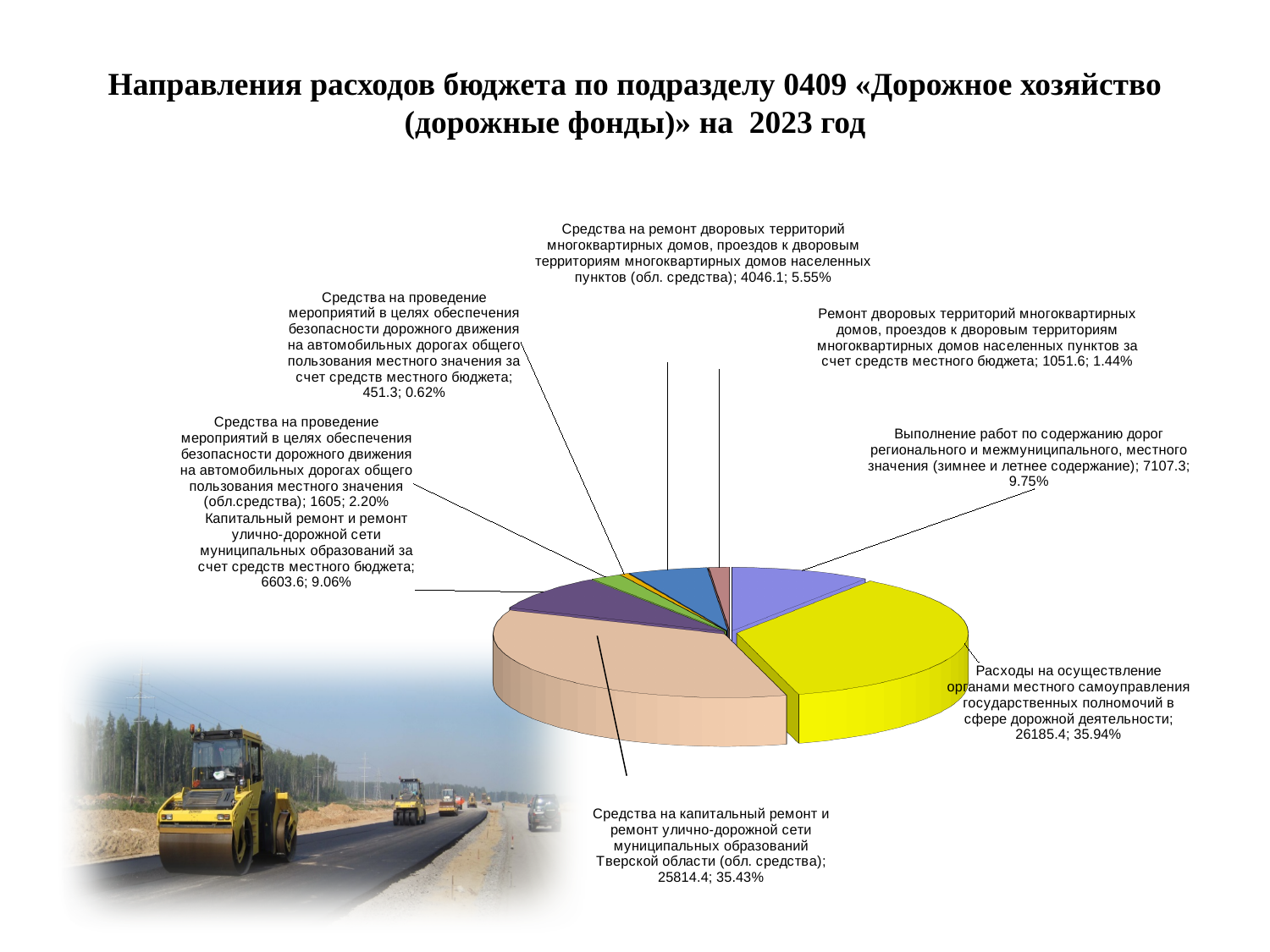
What is the difference between the values for «Средства на ремонт дворовых территорий ... (обл. средства)» (4046.1) and «Ремонт дворовых территорий ... за счет средств местного бюджета» (1051.6)? 2994.5 What kind of chart is shown on the slide? pie chart What is the difference between the values for «Расходы на осуществление органами местного самоуправления государственных полномочий в сфере дорожной деятельности» (26185.4) and «Средства на капитальный ремонт и ремонт улично-дорожной сети муниципальных образований Тверской области (обл. средства)» (25814.4)? 371 What is the value for «Выполнение работ по содержанию дорог регионального и межмуниципального, местного значения (зимнее и летнее содержание)»? 7107.3 What is the value for «Расходы на осуществление органами местного самоуправления государственных полномочий в сфере дорожной деятельности»? 26185.4 What is the value for «Средства на ремонт дворовых территорий многоквартирных домов, проездов к дворовым территориям многоквартирных домов населенных пунктов (обл. средства)»? 4046.1 How many slices does the pie chart have? 8 What share of the pie does «Капитальный ремонт и ремонт улично-дорожной сети муниципальных образований за счет средств местного бюджета» represent? 9.06% What share of the pie does «Средства на капитальный ремонт и ремонт улично-дорожной сети муниципальных образований Тверской области (обл. средства)» represent? 35.43% Which category has the largest slice of the pie? Расходы на осуществление органами местного самоуправления государственных полномочий в сфере дорожной деятельности Which is larger: the value for «Выполнение работ по содержанию дорог ... (зимнее и летнее содержание)» or the value for «Капитальный ремонт и ремонт улично-дорожной сети муниципальных образований за счет средств местного бюджета»? Выполнение работ по содержанию дорог регионального и межмуниципального, местного значения (зимнее и летнее содержание) Which category has the smallest slice of the pie? Средства на проведение мероприятий в целях обеспечения безопасности дорожного движения на автомобильных дорогах общего пользования местного значения за счет средств местного бюджета